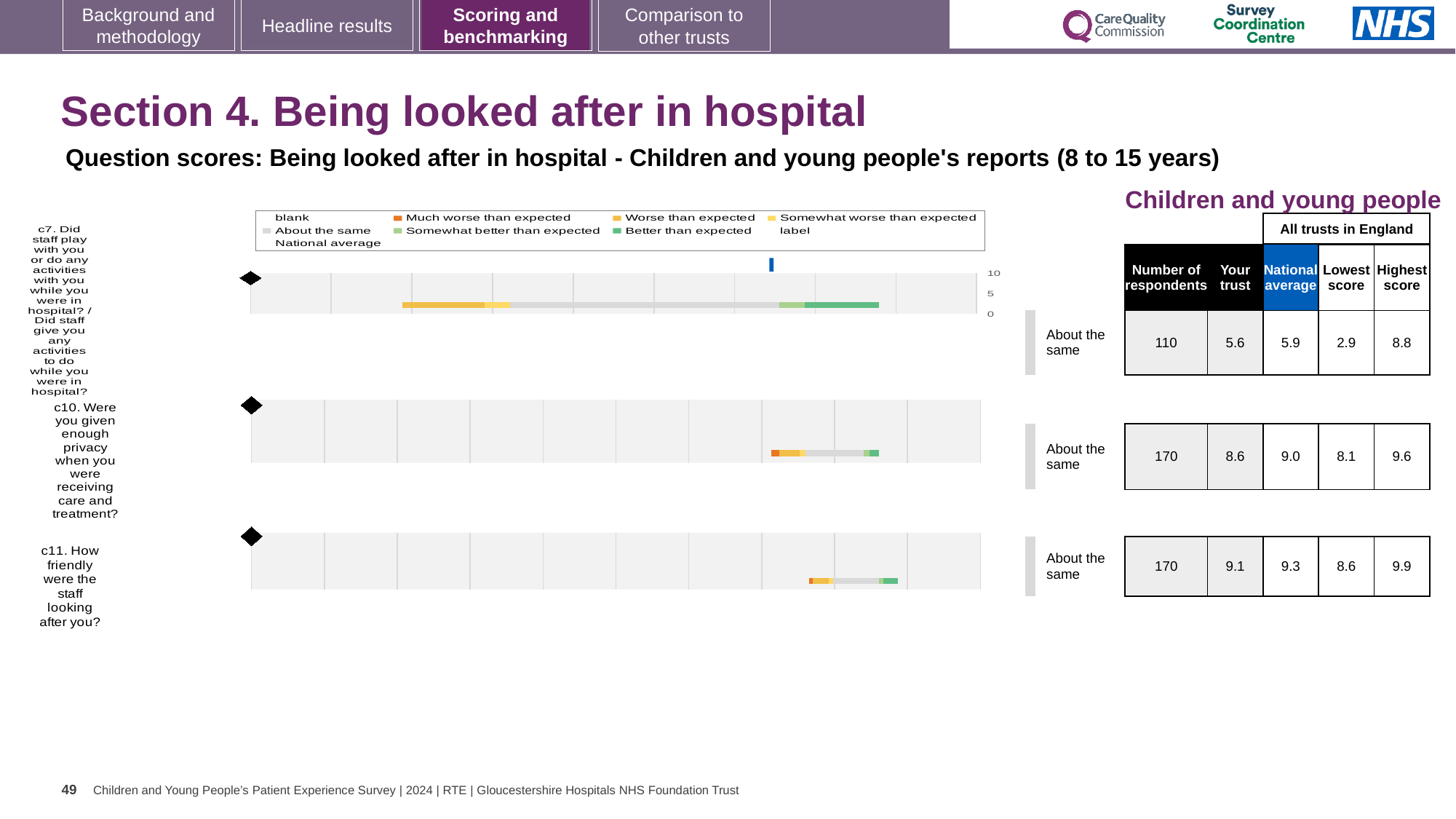
What benchmark category is shown for question c7? About the same What is the 'Your trust' score for question c7 (Did staff play with you or do any activities with you while you were in hospital?)? 5.6 What is the difference between the national average and the 'Your trust' score for question c11? 0.2 What is the highest score among all trusts in England for question c11 (How friendly were the staff looking after you?)? 9.9 For question c10, which is larger: the 'Your trust' score or the national average? National average What is the difference between the highest score and the lowest score for question c10? 1.5 Which question has the lowest 'Your trust' score? c7 How many questions are plotted on the slide? 3 What kind of chart is used to show the question scores? Bar chart What is the national average score for question c10 (Were you given enough privacy when you were receiving care and treatment?)? 9.0 How many respondents answered question c7? 110 Which question has the highest 'Your trust' score? c11